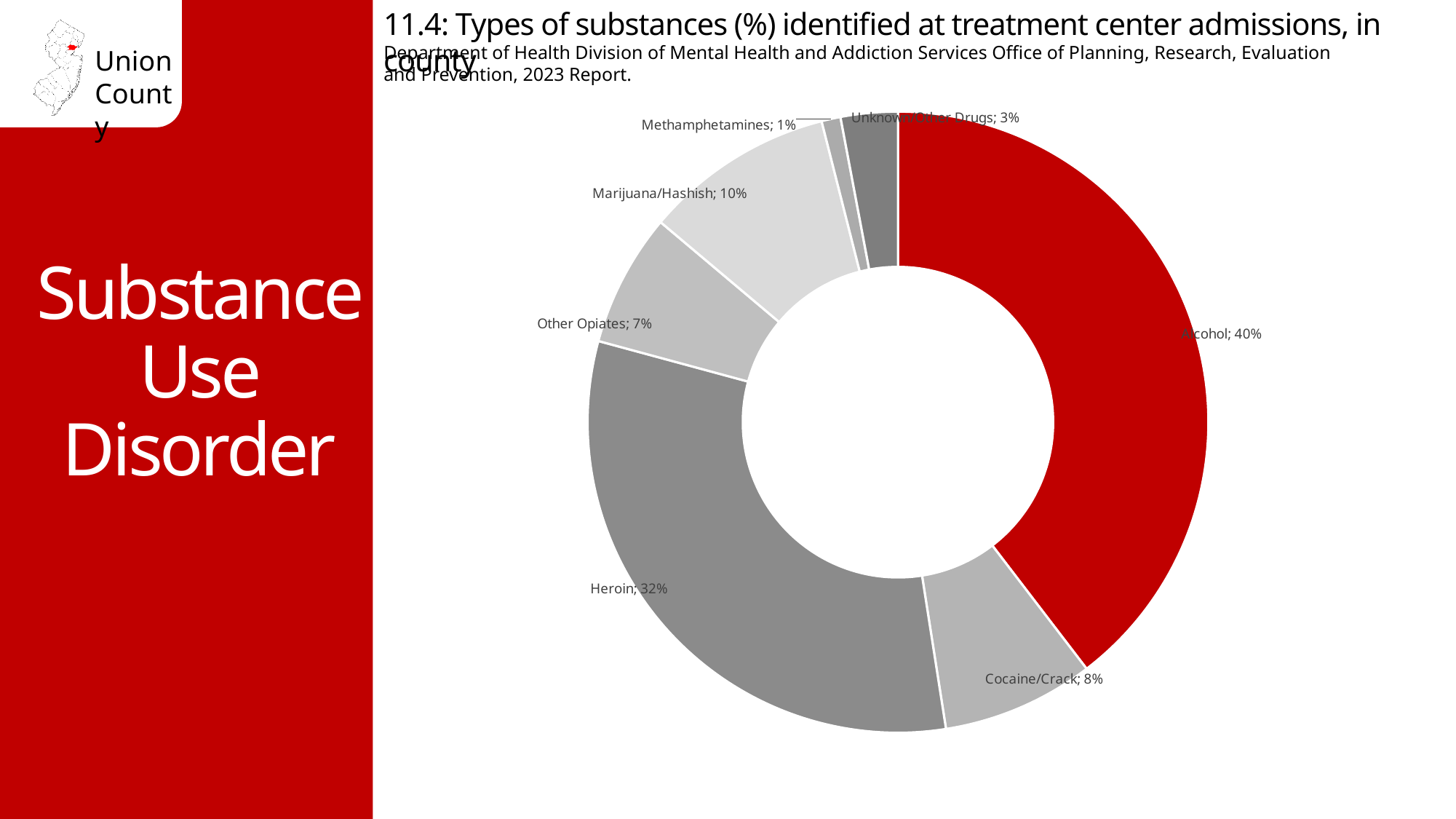
How many substance categories are shown in the chart? 7 Which substance has the largest share of admissions? Alcohol What kind of chart is used on this slide? doughnut chart What is the value for Other Opiates? 7% What is the difference in percentage points between Alcohol and Heroin? 8 Which is larger, the share for Marijuana/Hashish or the share for Cocaine/Crack? Marijuana/Hashish Which substance has the smallest share of admissions? Methamphetamines What is the value for Marijuana/Hashish? 10% Which slice of the chart is coloured red? Alcohol What percentage is shown for Cocaine/Crack? 8% What percentage of treatment center admissions is attributed to Alcohol? 40% What percentage is shown for Heroin? 32%